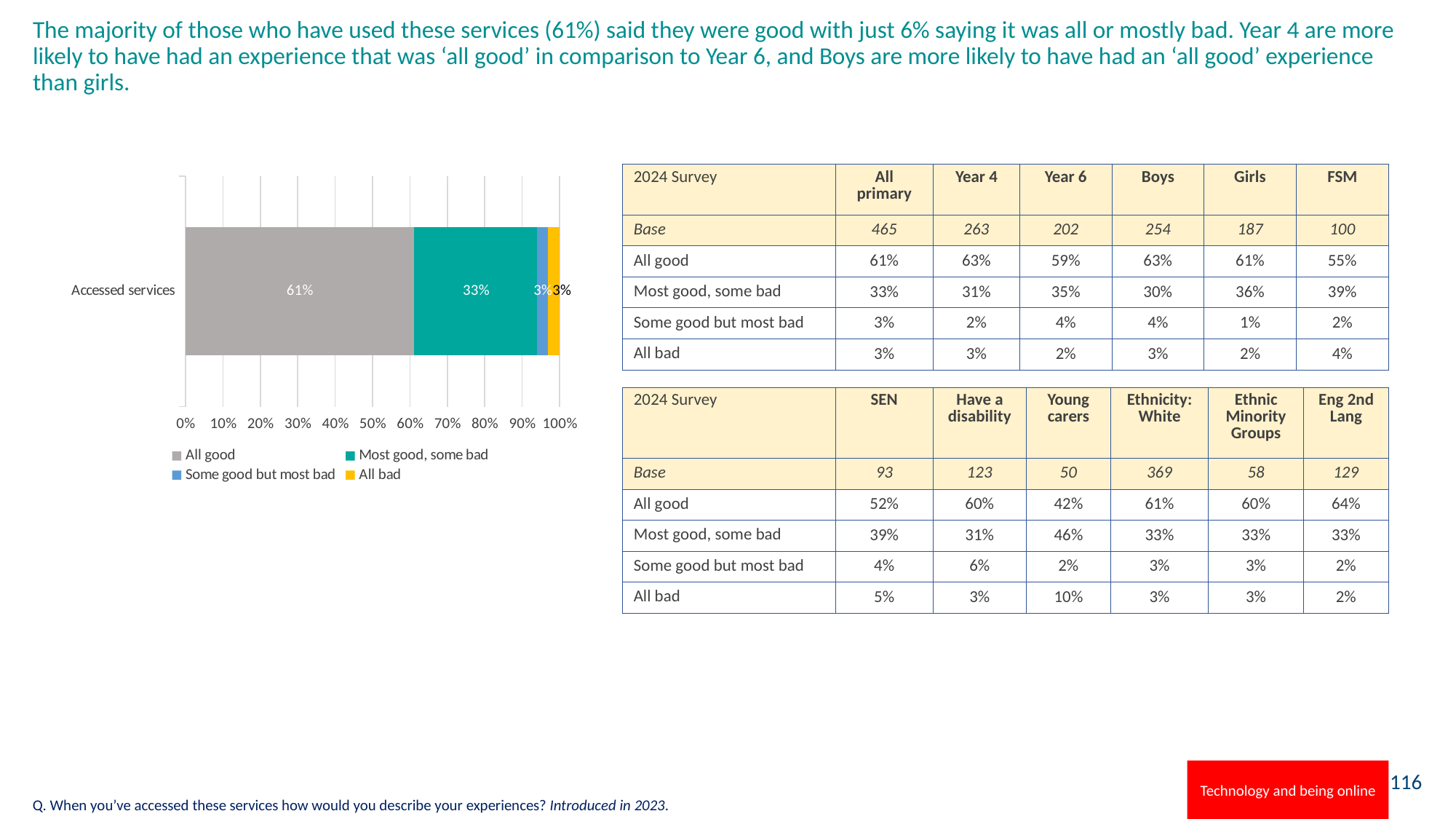
How many series does the chart legend list? 4 What percentage of the 'Accessed services' bar is 'All good'? 61% What colour is the 'All bad' series in the chart? Yellow Is the 'All good' segment in the chart greater or less than 50%? greater What percentage of the 'Accessed services' bar is 'Most good, some bad'? 33% How many categories are plotted on the chart's vertical axis? 1 Which is larger in the chart: 'All good' or 'Most good, some bad'? All good What is the total of the 'All good' and 'Most good, some bad' segments in the chart? 94% What kind of chart is shown on the slide? Stacked bar chart What percentage of the 'Accessed services' bar is 'All bad'? 3% Which series has the largest segment in the 'Accessed services' bar? All good What is the difference between the 'All good' and 'Most good, some bad' segments in the chart? 28%